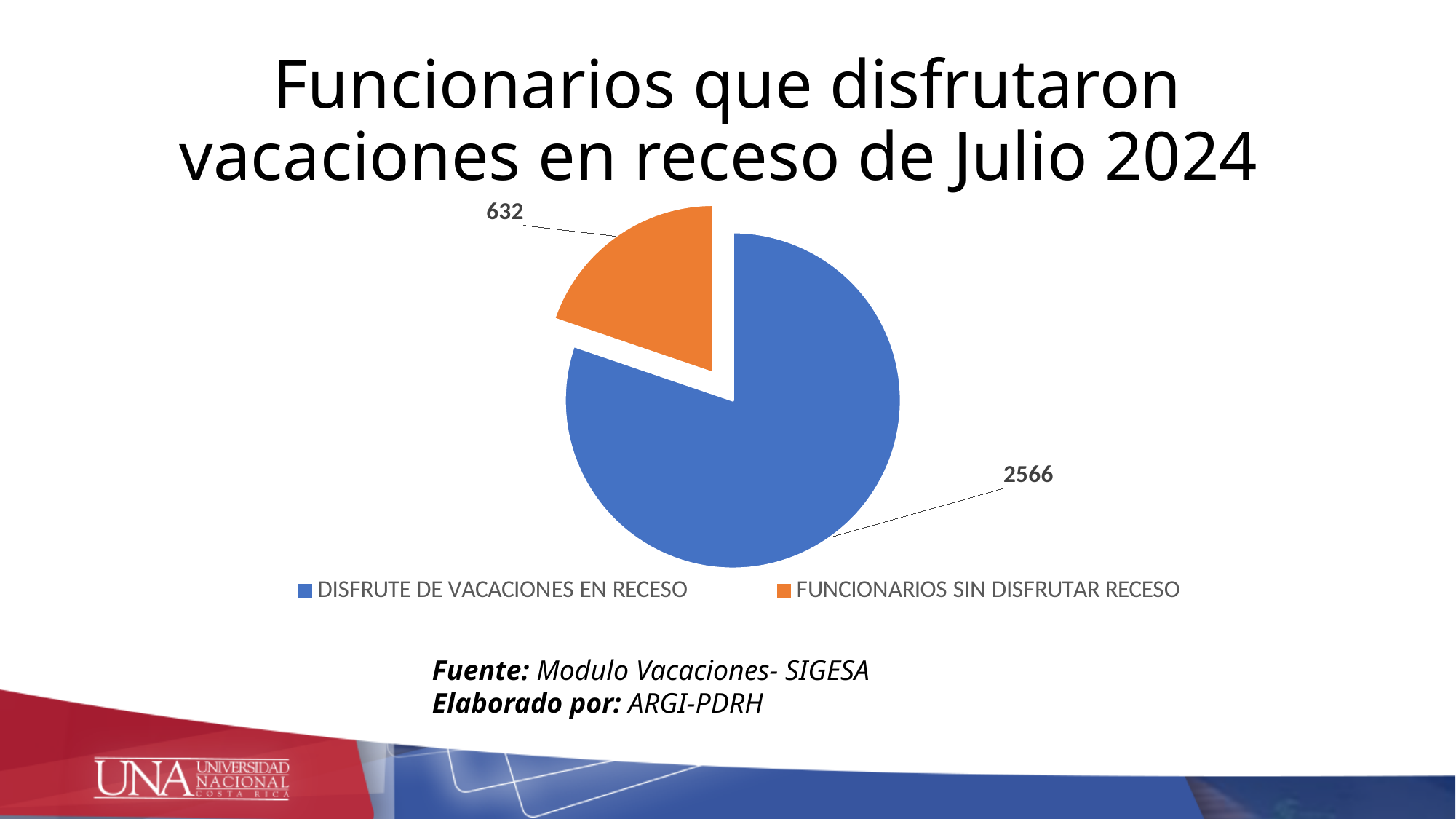
What is the difference between the value for DISFRUTE DE VACACIONES EN RECESO and the value for FUNCIONARIOS SIN DISFRUTAR RECESO? 1934 Which is larger, the value for DISFRUTE DE VACACIONES EN RECESO or the value for FUNCIONARIOS SIN DISFRUTAR RECESO? DISFRUTE DE VACACIONES EN RECESO Which category has the largest slice of the pie? DISFRUTE DE VACACIONES EN RECESO What kind of chart is shown on the slide? Pie chart What is the value for FUNCIONARIOS SIN DISFRUTAR RECESO? 632 What is the total of all slices in the pie chart? 3198 What share of the pie does FUNCIONARIOS SIN DISFRUTAR RECESO represent, to the nearest whole percent? 20% What is the value for DISFRUTE DE VACACIONES EN RECESO? 2566 What colour is the slice for FUNCIONARIOS SIN DISFRUTAR RECESO? Orange How many entries does the legend list? 2 How many categories does the pie chart have? 2 Which category has the smallest slice of the pie? FUNCIONARIOS SIN DISFRUTAR RECESO